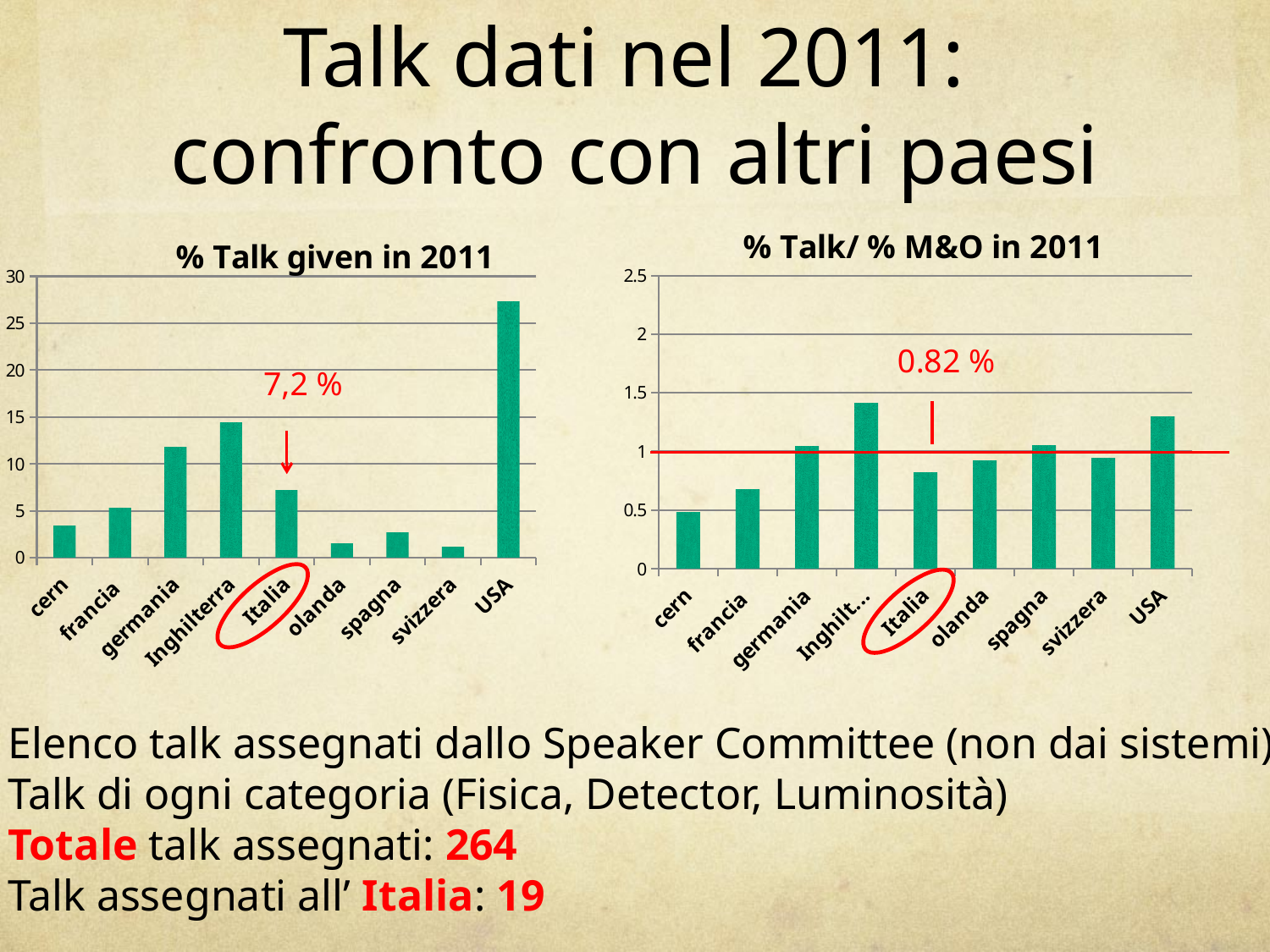
In the '% Talk/ % M&O in 2011' chart, is the value for francia greater or less than 1? less In the '% Talk/ % M&O in 2011' chart, which country has the highest bar? Inghilterra What type of chart is the '% Talk/ % M&O in 2011' chart? bar chart In the '% Talk given in 2011' chart, is the value for cern greater or less than 5? less In the '% Talk given in 2011' chart, which is larger, the value for germania or the value for francia? germania In the '% Talk given in 2011' chart, is the value for USA greater or less than 25? greater In the '% Talk/ % M&O in 2011' chart, which country has the lowest bar? cern In the '% Talk given in 2011' chart, which country has the lowest bar? svizzera How many countries are shown in the '% Talk given in 2011' chart? 9 In the '% Talk/ % M&O in 2011' chart, what value is annotated for Italia? 0.82 % In the '% Talk given in 2011' chart, which country has the highest bar? USA In the '% Talk given in 2011' chart, what value is annotated for Italia? 7,2 %